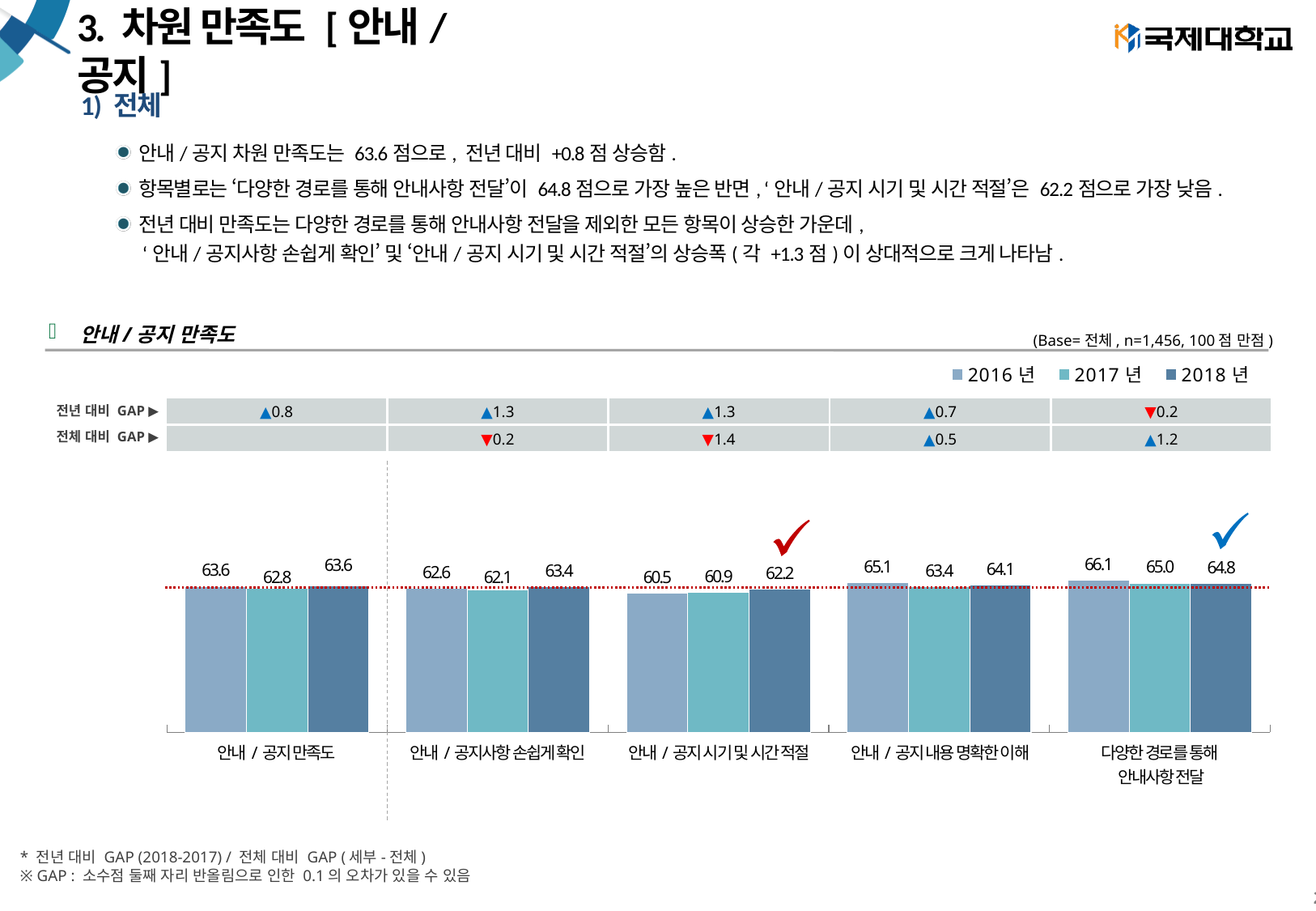
What is the 전년 대비 GAP shown for 안내 / 공지 시기 및 시간 적절? ▲1.3 Do the values for 다양한 경로를 통해 안내사항 전달 rise or fall from 2016년 to 2018년? fall What is the 2018년 value for 안내 / 공지 시기 및 시간 적절? 62.2 How many series does the legend list? 3 What is the difference between the 2018년 and 2017년 values for 안내 / 공지사항 손쉽게 확인? 1.3 What is the 2017년 value for 안내 / 공지 내용 명확한 이해? 63.4 Which is larger for 안내 / 공지 내용 명확한 이해: the 2016년 value or the 2018년 value? 2016년 What kind of chart is shown on the slide? bar chart Which category has the highest 2018년 value? 다양한 경로를 통해 안내사항 전달 What is the 2016년 value for 다양한 경로를 통해 안내사항 전달? 66.1 Which category has the lowest 2017년 value? 안내 / 공지 시기 및 시간 적절 How many categories are shown on the x axis of the chart? 5